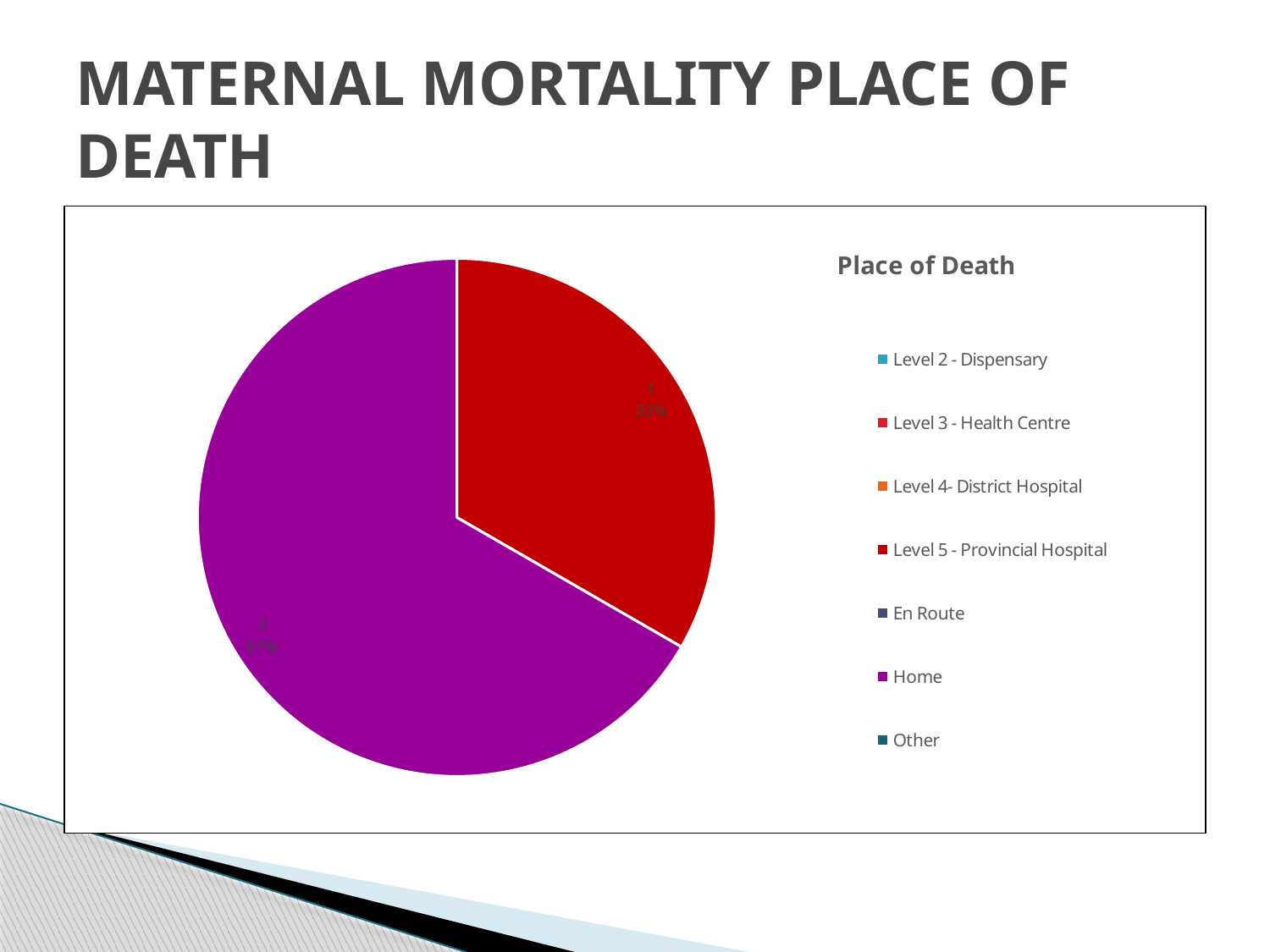
Which is larger, the slice for Home or the slice for Level 5 - Provincial Hospital? Home What percentage share of the pie does Level 5 - Provincial Hospital account for? 33% What percentage share of the pie does Home account for? 67% What is the number of deaths shown for Level 5 - Provincial Hospital? 1 What is the total number of deaths represented by the two slices of the pie? 3 Which place of death has the largest slice of the pie? Home How many entries does the chart's legend list? 7 What is the title of the chart? Place of Death How many slices are visible in the pie chart? 2 What is the number of deaths shown for Home? 2 What kind of chart is shown on the slide? pie chart What is the difference in the number of deaths between Home and Level 5 - Provincial Hospital? 1